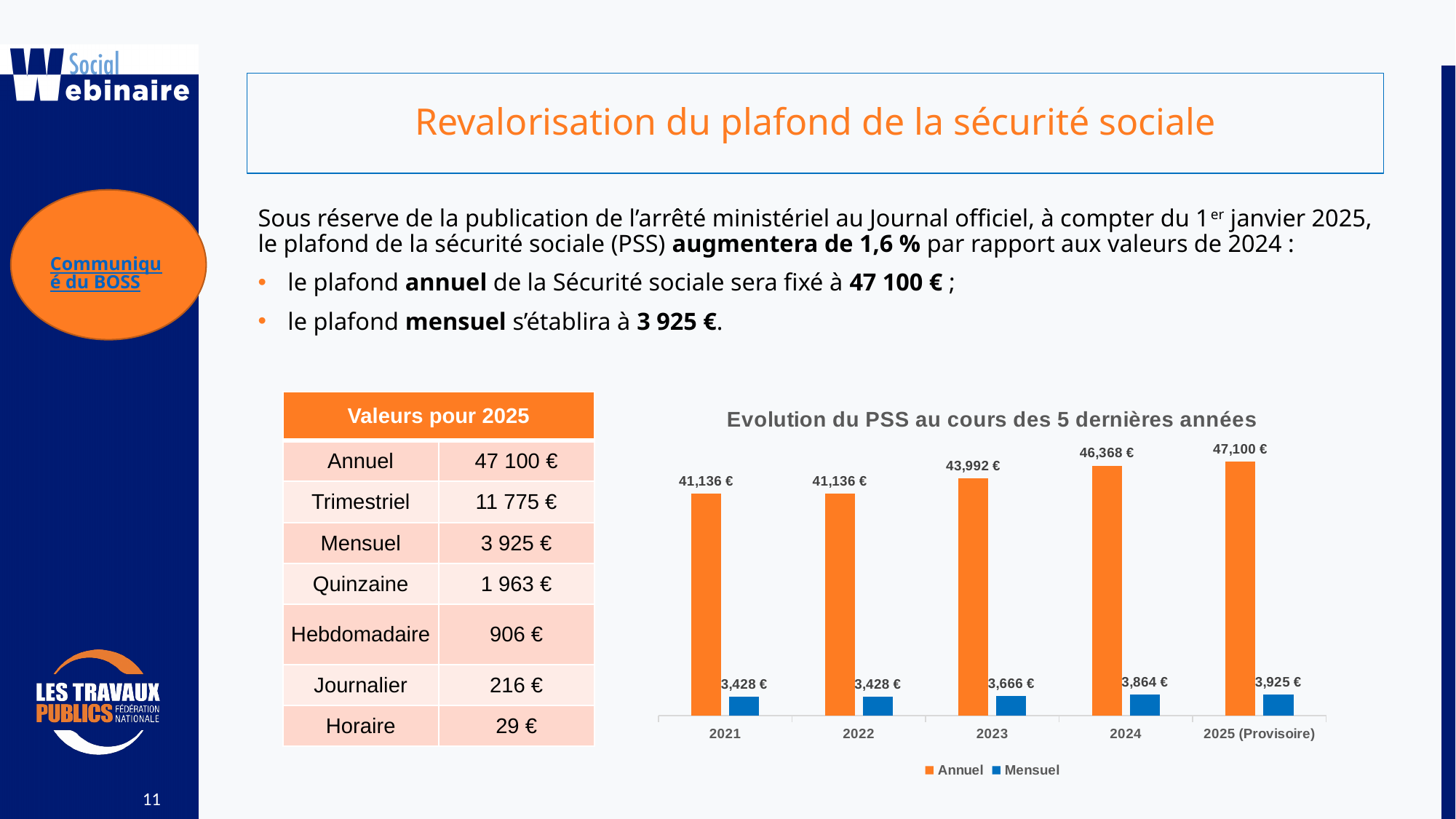
How many series does the chart legend list? 2 What type of chart is shown on the slide? bar chart What is the Annuel value for 2023 in the chart? 43,992 € Which year has the highest Annuel value in the chart? 2025 (Provisoire) How many years are shown on the x axis of the chart? 5 What is the Annuel value for 2025 (Provisoire) in the chart? 47,100 € Is the Annuel value for 2024 larger or smaller than the Annuel value for 2022? larger What is the Mensuel value for 2021 in the chart? 3,428 € What is the Mensuel value for 2024 in the chart? 3,864 € Which year has the lowest Mensuel value in the chart, 2023 or 2024? 2023 What is the difference between the Mensuel values for 2025 (Provisoire) and 2024? 61 € What is the difference between the Annuel values for 2024 and 2023? 2,376 €